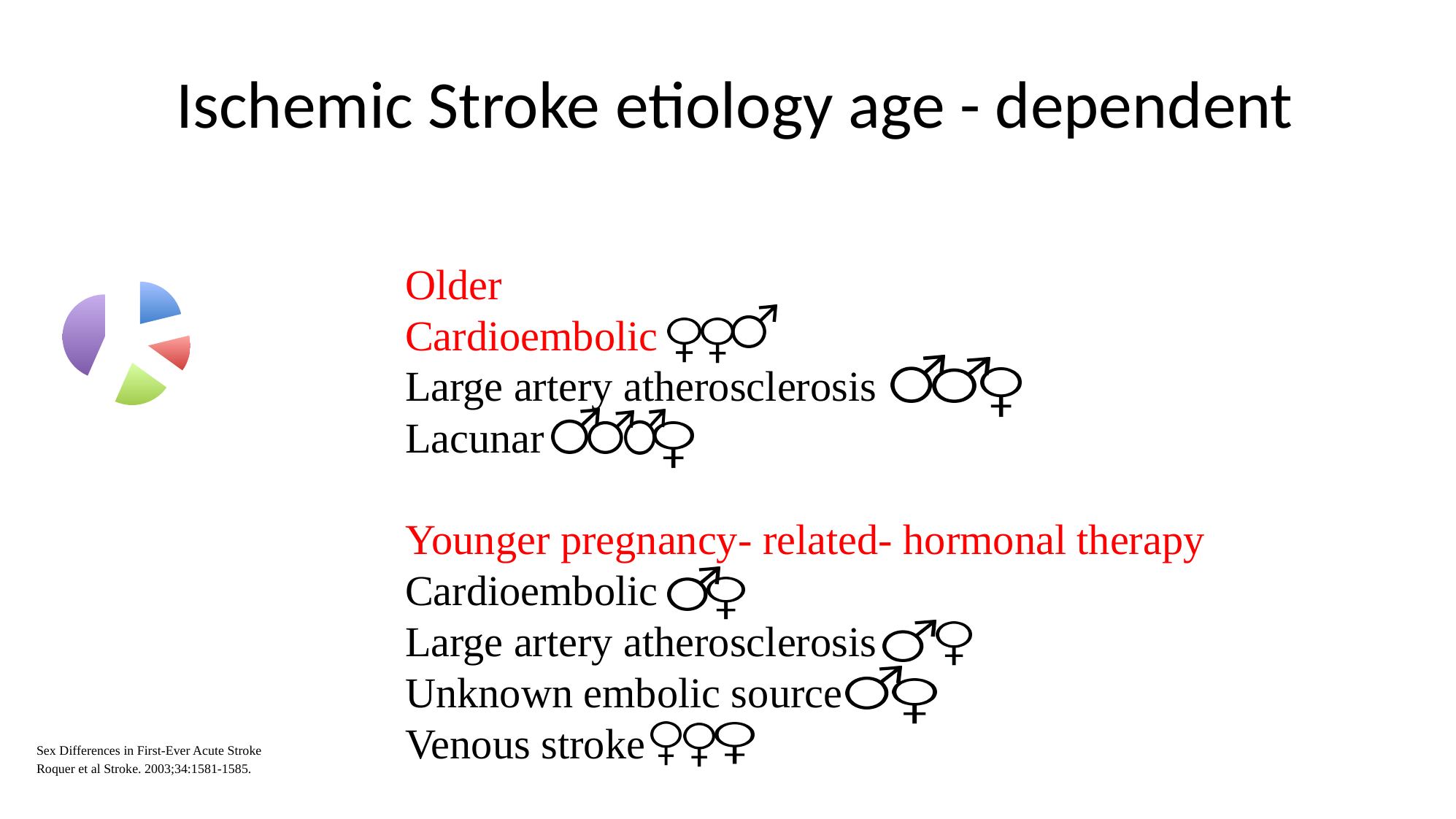
In the pie chart on the left of the slide, is the red slice larger or smaller than the green slice? smaller What kind of chart is shown on the left of the slide? pie chart In the pie chart on the left of the slide, is the purple slice larger or smaller than the blue slice? larger Which colour slice is the largest in the pie chart on the left of the slide? purple Does the pie chart on the left of the slide have a legend? No Which colour slice is the smallest in the pie chart on the left of the slide? red How many slices does the pie chart on the left of the slide have? 4 Does the pie chart on the left of the slide show data labels on its slices? No